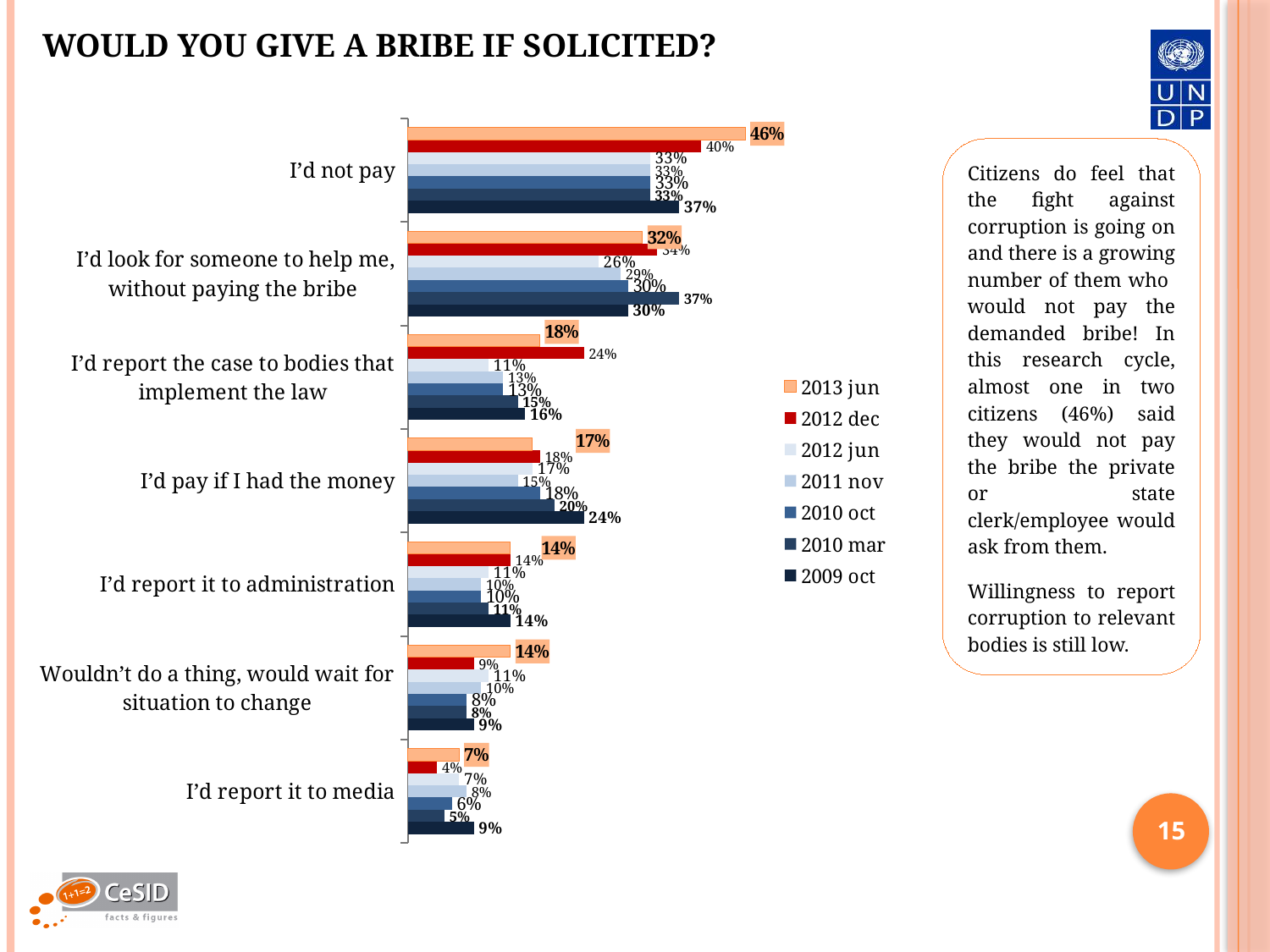
How many response categories are shown on the chart? 7 By how many percentage points did "I'd not pay" change from 2012 dec to 2013 jun? 6 percentage points What is the 2009 oct value for "I'd pay if I had the money"? 24% Which response category has the highest value in the 2013 jun series? I'd not pay Which response category has the lowest value in the 2013 jun series? I'd report it to media For "I'd report the case to bodies that implement the law", which is larger: the 2012 dec value or the 2013 jun value? 2012 dec What is the 2012 dec value for "I'd report it to media"? 4% How many survey waves does the legend list? 7 What type of chart is shown on the slide? Bar chart What percentage of respondents said "I'd not pay" in the 2013 jun survey? 46% What is the 2010 mar value for "I'd look for someone to help me, without paying the bribe"? 37% Which survey wave is listed first in the legend? 2013 jun